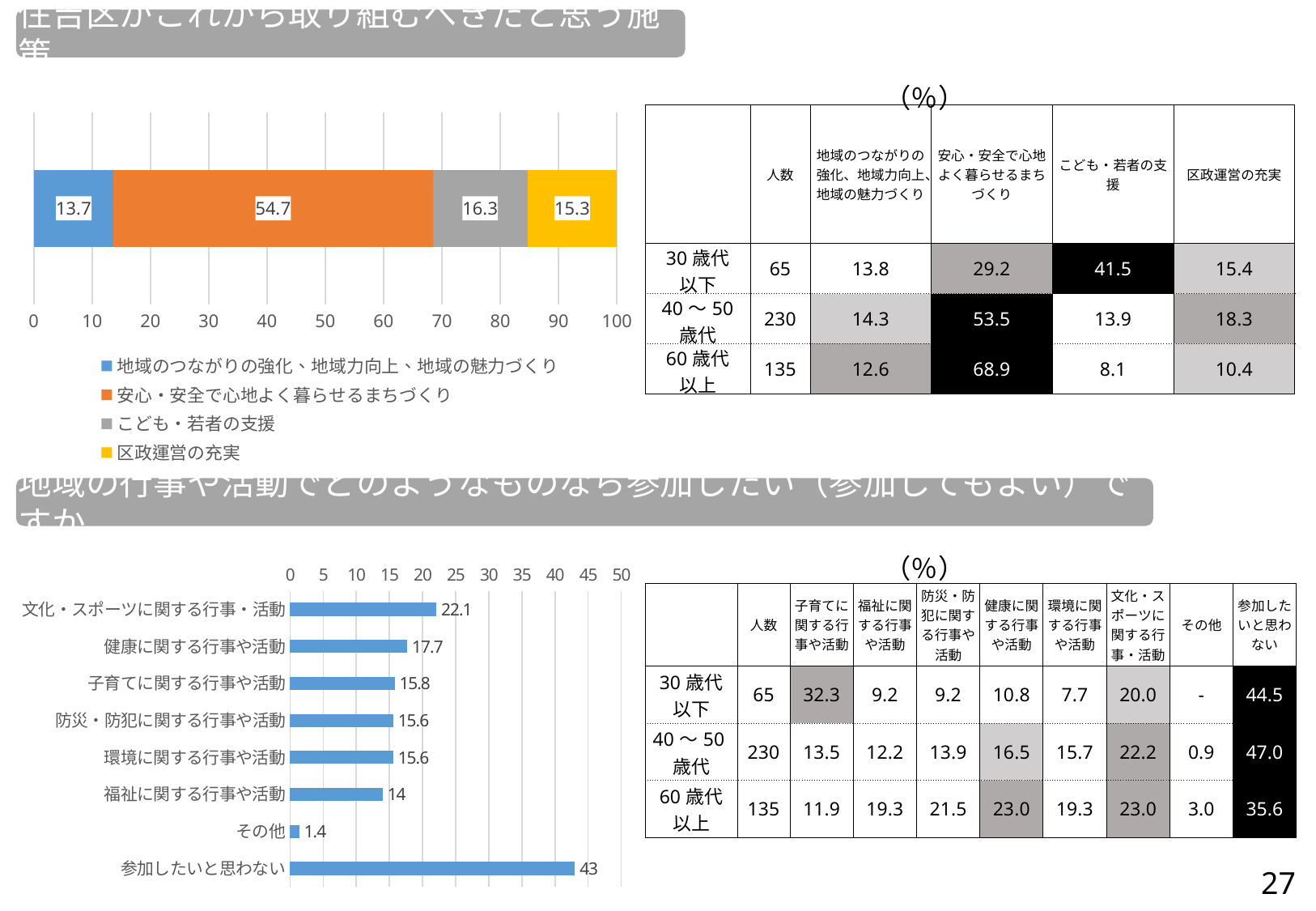
In the bottom chart, which category has the lowest value? その他 What kind of chart is the bottom chart? Bar chart In the top chart, what is the total of the stacked bar? 100 In the bottom chart, what is the difference between 文化・スポーツに関する行事・活動 and 福祉に関する行事や活動? 8.1 In the bottom chart, which category has the highest value? 参加したいと思わない In the top chart, what is the difference between こども・若者の支援 and 地域のつながりの強化、地域力向上、地域の魅力づくり? 2.6 In the bottom chart, what is the value for 健康に関する行事や活動? 17.7 In the top chart, how many series does the legend list? 4 In the top chart, what is the value for 安心・安全で心地よく暮らせるまちづくり? 54.7 In the top chart, which segment has the largest value? 安心・安全で心地よく暮らせるまちづくり In the bottom chart, how many categories are shown? 8 In the top chart, what is the value for 区政運営の充実? 15.3